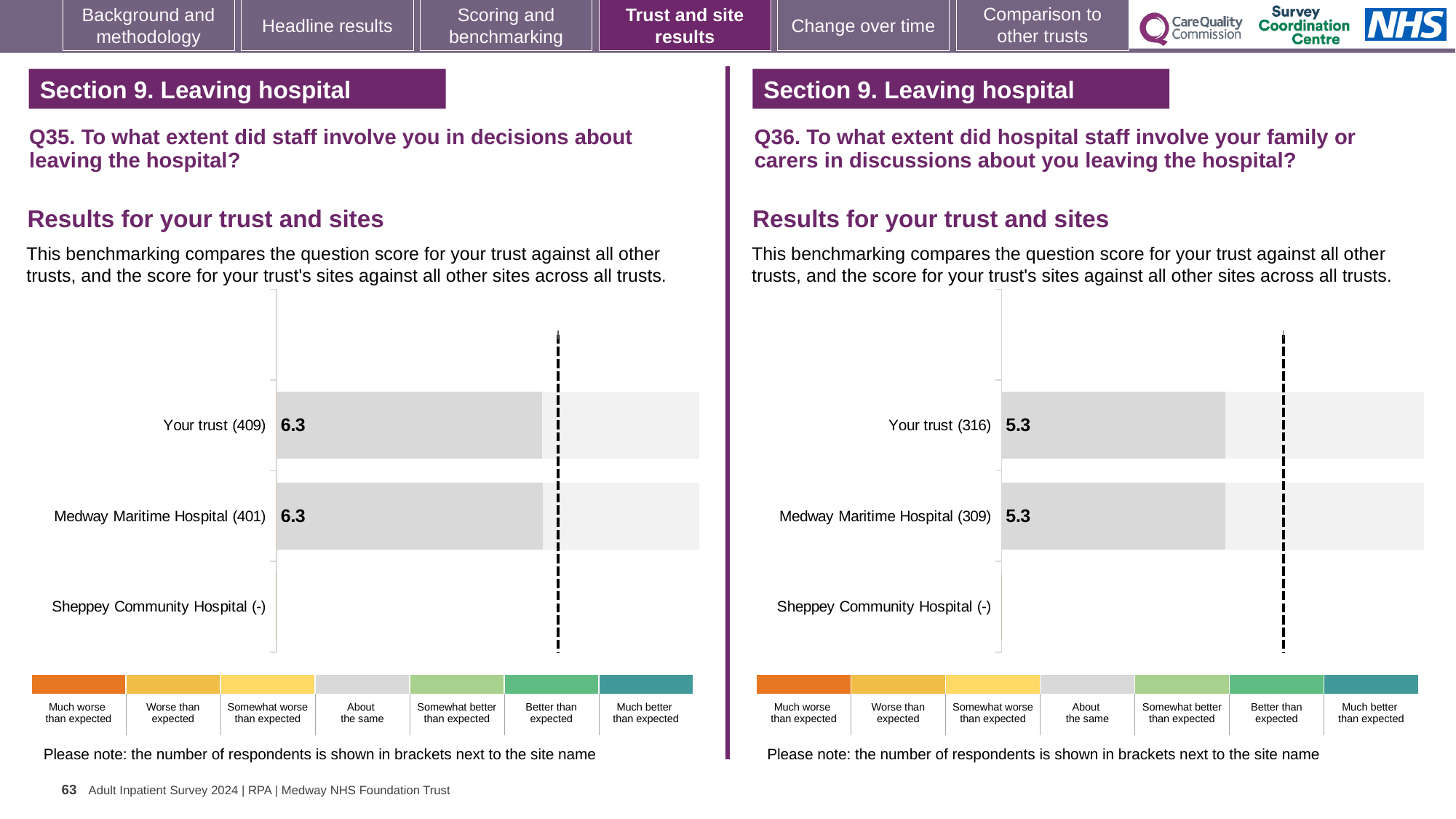
On the Q36 chart (right), what is the score for Your trust? 5.3 On the Q36 chart (right), what is the difference between the score for Your trust and the score for Medway Maritime Hospital? 0 Which is larger: the Your trust score on the Q35 chart (left) or the Your trust score on the Q36 chart (right)? Q35 chart (left) How many site/trust categories are listed on the Q35 chart (left)? 3 On the Q35 chart (left), what is the score for Medway Maritime Hospital? 6.3 On the Q35 chart (left), what is the difference between the score for Your trust and the score for Medway Maritime Hospital? 0 On the Q36 chart (right), what is the score for Medway Maritime Hospital? 5.3 On the Q35 chart (left), how many respondents are shown in brackets for Your trust? 409 On the Q36 chart (right), how many respondents are shown in brackets for Medway Maritime Hospital? 309 On the Q36 chart (right), which category has no score shown? Sheppey Community Hospital What kind of chart is the Q36 chart (right)? Bar chart On the Q35 chart (left), what is the score for Your trust? 6.3